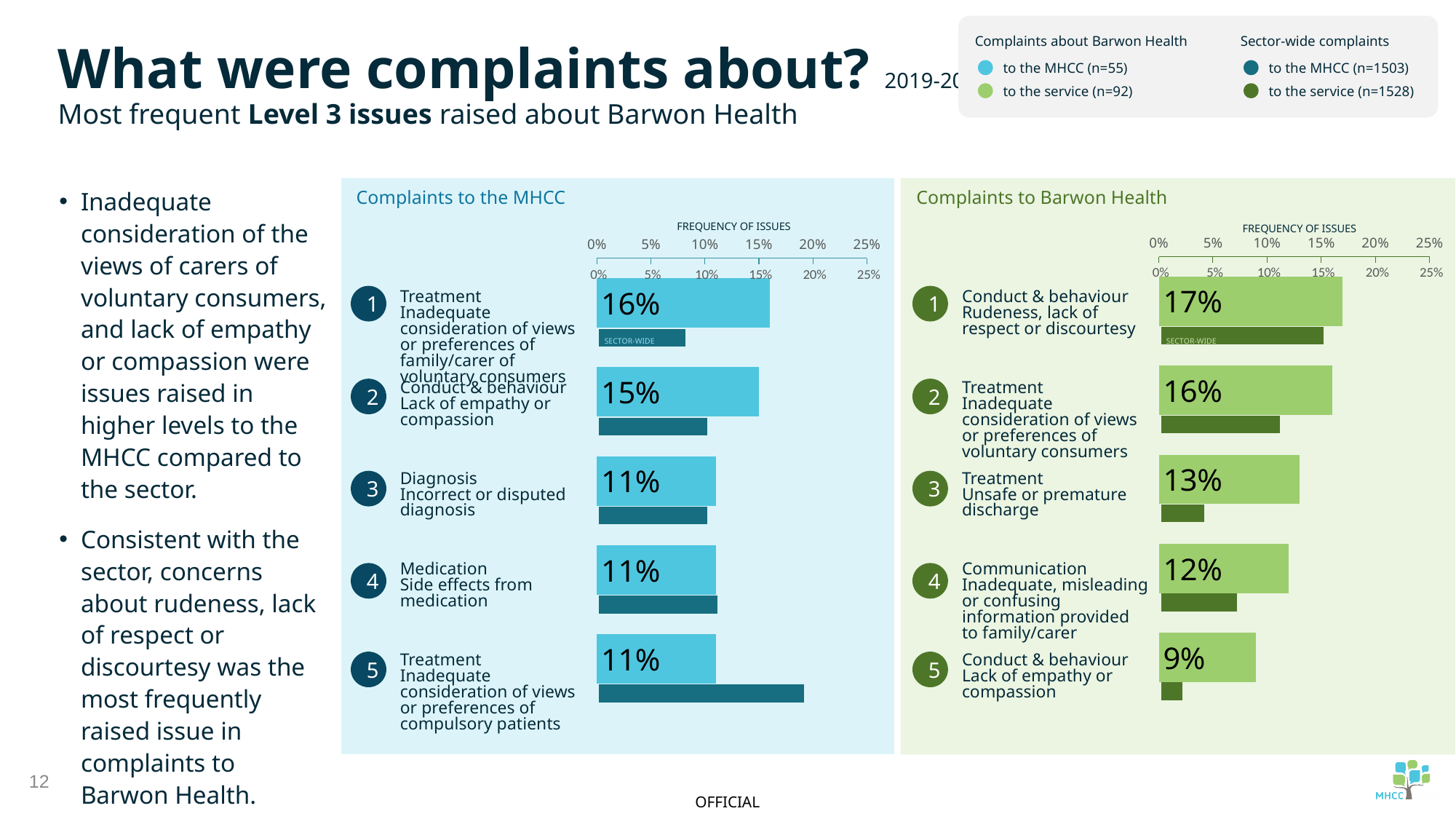
In the 'Complaints to the MHCC' chart, is the sector-wide value for Treatment (Inadequate consideration of views or preferences of compulsory patients) greater or less than 15%? greater In the 'Complaints to Barwon Health' chart, which issue has the lowest value? Conduct & behaviour (Lack of empathy or compassion) In the 'Complaints to Barwon Health' chart, what is the value for Conduct & behaviour (Lack of empathy or compassion)? 9% In the 'Complaints to Barwon Health' chart, what is the value for Treatment (Unsafe or premature discharge)? 13% In the 'Complaints to the MHCC' chart, what is the difference between the value for Treatment (Inadequate consideration of views or preferences of family/carer of voluntary consumers) and the value for Diagnosis? 5% Which is larger: the value for Medication in the 'Complaints to the MHCC' chart or the value for Communication in the 'Complaints to Barwon Health' chart? Communication in the 'Complaints to Barwon Health' chart What kind of chart is the 'Complaints to the MHCC' chart? bar chart In the 'Complaints to Barwon Health' chart, what is the difference between the value for Conduct & behaviour (Rudeness, lack of respect or discourtesy) and the value for Communication? 5% In the 'Complaints to Barwon Health' chart, which issue has the highest value? Conduct & behaviour (Rudeness, lack of respect or discourtesy) How many issues are listed in the 'Complaints to Barwon Health' chart? 5 In the 'Complaints to the MHCC' chart, what is the value for Diagnosis (Incorrect or disputed diagnosis)? 11% In the 'Complaints to the MHCC' chart, what is the value for Conduct & behaviour (Lack of empathy or compassion)? 15%